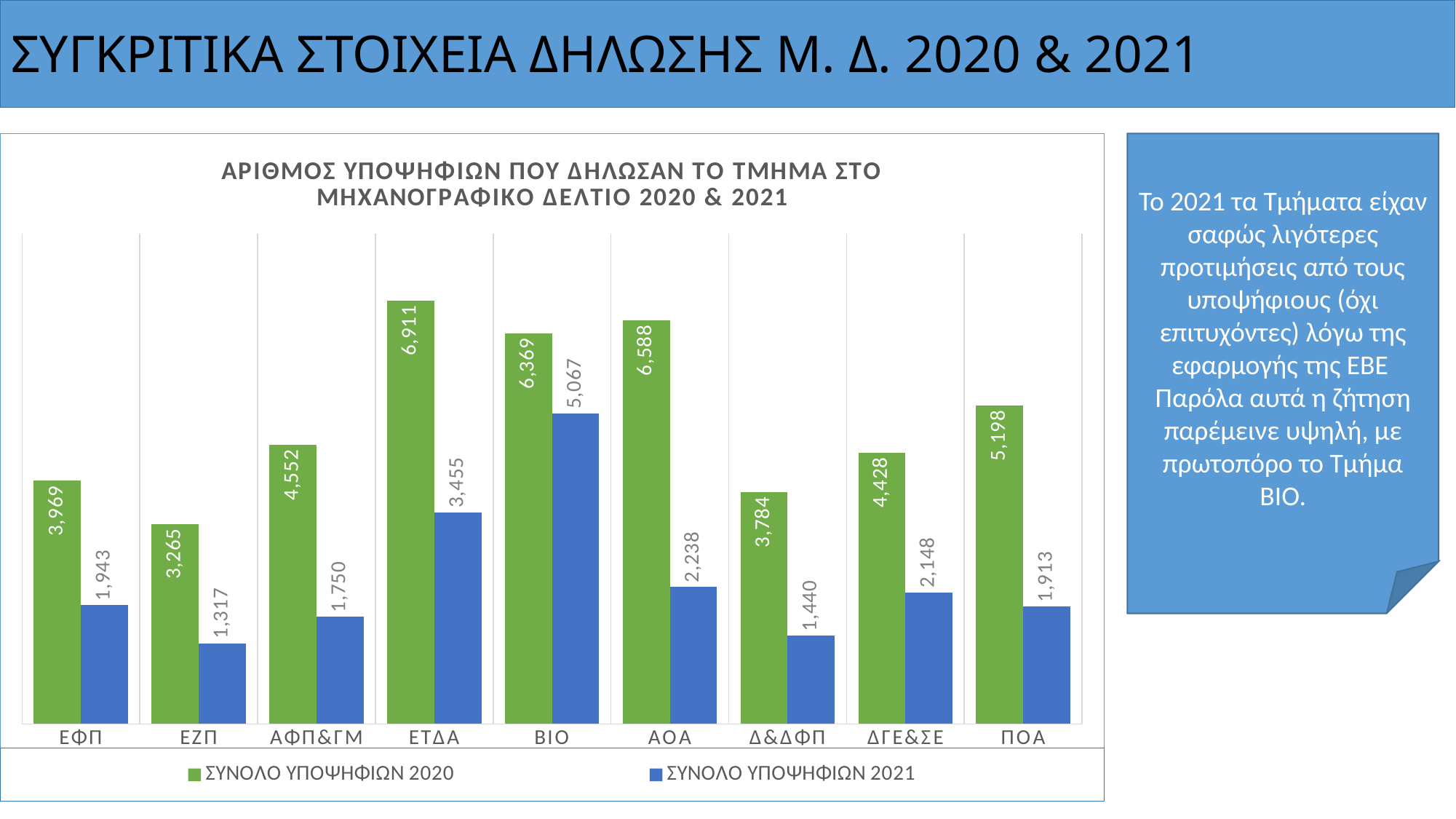
Which category has the highest value in the ΣΥΝΟΛΟ ΥΠΟΨΗΦΙΩΝ 2020 series? ΕΤΔΑ Which category has the highest value in the ΣΥΝΟΛΟ ΥΠΟΨΗΦΙΩΝ 2021 series? ΒΙΟ How many series does the legend list? 2 What is the difference between the 2020 and 2021 values for ΕΤΔΑ? 3,456 Which is larger in the ΣΥΝΟΛΟ ΥΠΟΨΗΦΙΩΝ 2020 series: ΒΙΟ or ΑΟΑ? ΑΟΑ Which category has the lowest value in the ΣΥΝΟΛΟ ΥΠΟΨΗΦΙΩΝ 2021 series? ΕΖΠ What is the value for ΒΙΟ in the ΣΥΝΟΛΟ ΥΠΟΨΗΦΙΩΝ 2021 series? 5,067 What is the difference between the 2020 and 2021 values for ΠΟΑ? 3,285 What is the value for Δ&ΔΦΠ in the ΣΥΝΟΛΟ ΥΠΟΨΗΦΙΩΝ 2021 series? 1,440 What kind of chart is shown on the slide? Bar chart How many categories are shown on the x axis of the chart? 9 What is the value for ΑΦΠ&ΓΜ in the ΣΥΝΟΛΟ ΥΠΟΨΗΦΙΩΝ 2020 series? 4,552